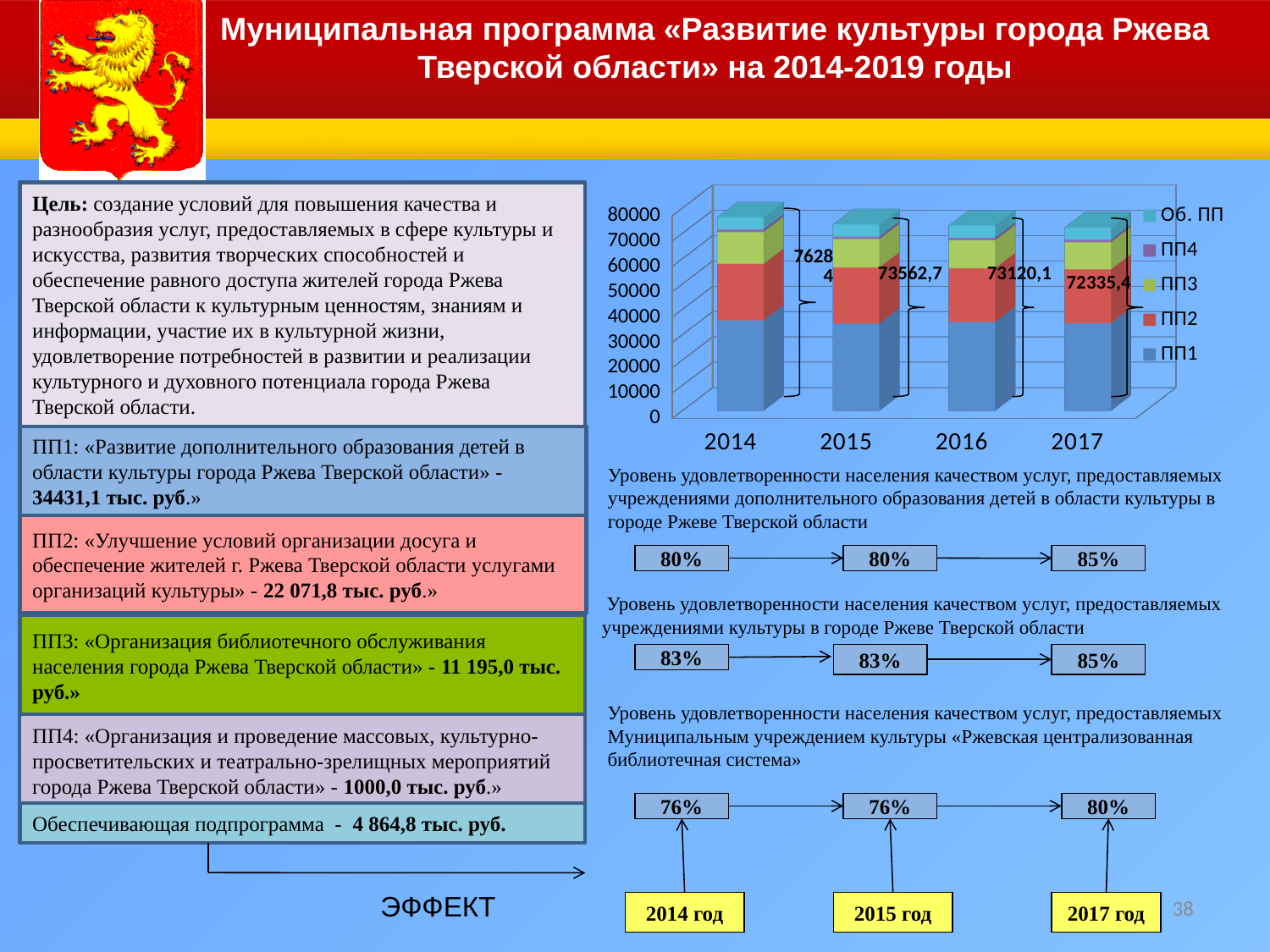
How many years are shown on the x axis of the chart? 4 What is the difference between the labelled totals for 2016 and 2017? 784,7 Which bar total is larger, 2015 or 2017? 2015 What total value is labelled on the bar for 2016? 73120,1 Which year has the shortest bar in the chart? 2017 What total value is labelled on the bar for 2017? 72335,4 Do the bar totals rise or fall from 2014 to 2017? fall What is the difference between the labelled totals for 2015 and 2016? 442,6 How many series does the chart legend list? 5 What total value is labelled on the bar for 2015? 73562,7 Which year has the tallest bar in the chart? 2014 What kind of chart is shown on the slide? bar chart